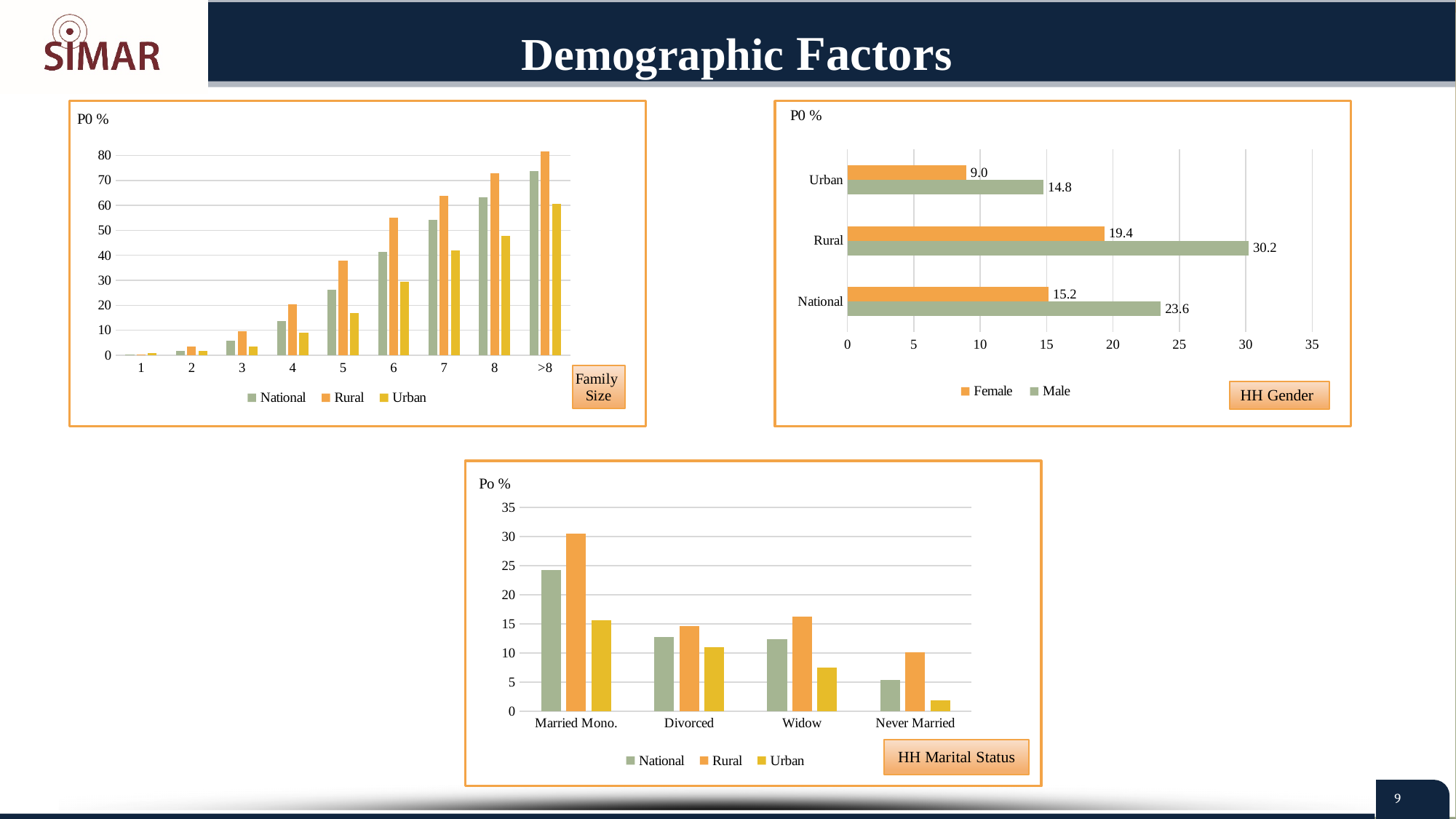
In the HH Marital Status chart, which category has the lowest Urban value? Never Married In the HH Gender chart, which category has the lowest Male value? Urban In the HH Gender chart, is the Female value for Rural larger or smaller than the Male value for Urban? larger In the HH Gender chart, which category has the highest Female value? Rural What kind of chart is the HH Gender chart? bar chart In the HH Gender chart, what is the Male value for Rural? 30.2 In the HH Marital Status chart, is the Rural value for Married Mono. greater or less than 25? greater In the HH Gender chart, what is the difference between the Male and Female values for National? 8.4 How many categories are shown on the x axis of the Family Size chart? 9 In the HH Gender chart, what is the Female value for Urban? 9.0 How many series does the legend of the Family Size chart list? 3 In the Family Size chart, do the values generally rise or fall as family size increases along the x axis? rise